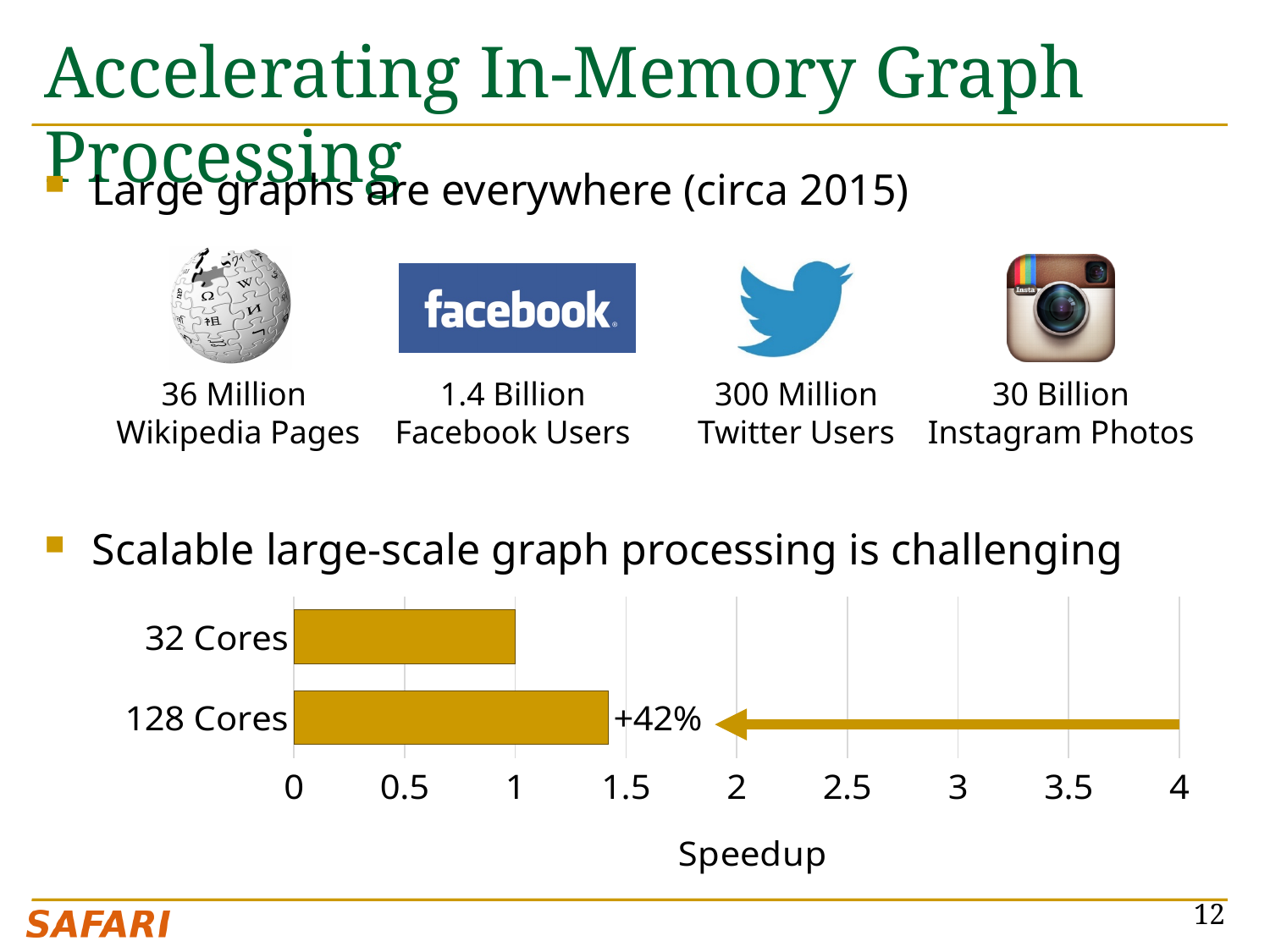
What is the speedup value for 32 Cores? 1 What percentage annotation is printed next to the 128 Cores bar? +42% What is the maximum value shown on the x axis of the bar chart? 4 Is the speedup for 128 Cores greater or less than 1? greater Which category has the lowest speedup? 32 Cores Is the speedup for 128 Cores greater or less than 2? less Is the speedup for 128 Cores greater or less than 1.5? less Which category has the highest speedup? 128 Cores Which category has the higher speedup, 32 Cores or 128 Cores? 128 Cores What kind of chart is shown on the slide? bar chart How many categories does the bar chart show? 2 What is the title of the x axis of the bar chart? Speedup